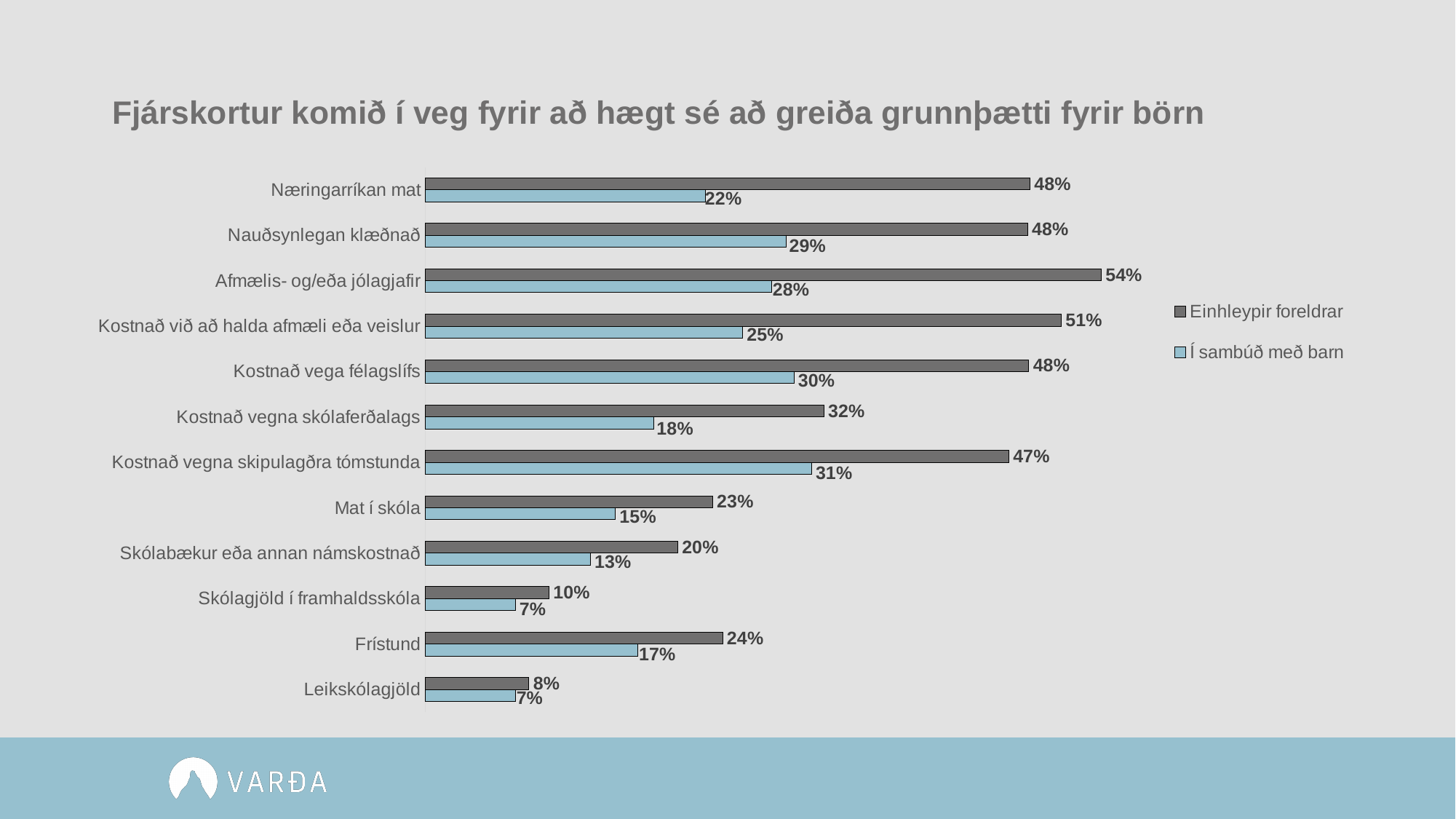
What is the value for Einhleypir foreldrar for Afmælis- og/eða jólagjafir? 54% What is the value for Í sambúð með barn for Kostnað vegna skipulagðra tómstunda? 31% What kind of chart is shown on the slide? Bar chart How many series does the legend list? 2 Which series is shown in light blue? Í sambúð með barn What is the title of the chart? Fjárskortur komið í veg fyrir að hægt sé að greiða grunnþætti fyrir börn What is the value for Í sambúð með barn for Næringarríkan mat? 22% What is the difference between the Einhleypir foreldrar and Í sambúð með barn values for Kostnað við að halda afmæli eða veislur? 26% Which category has the lowest value for Einhleypir foreldrar? Leikskólagjöld Which category has the highest value for Einhleypir foreldrar? Afmælis- og/eða jólagjafir Which is larger for Mat í skóla: the Einhleypir foreldrar value or the Í sambúð með barn value? Einhleypir foreldrar How many categories are shown in the chart? 12